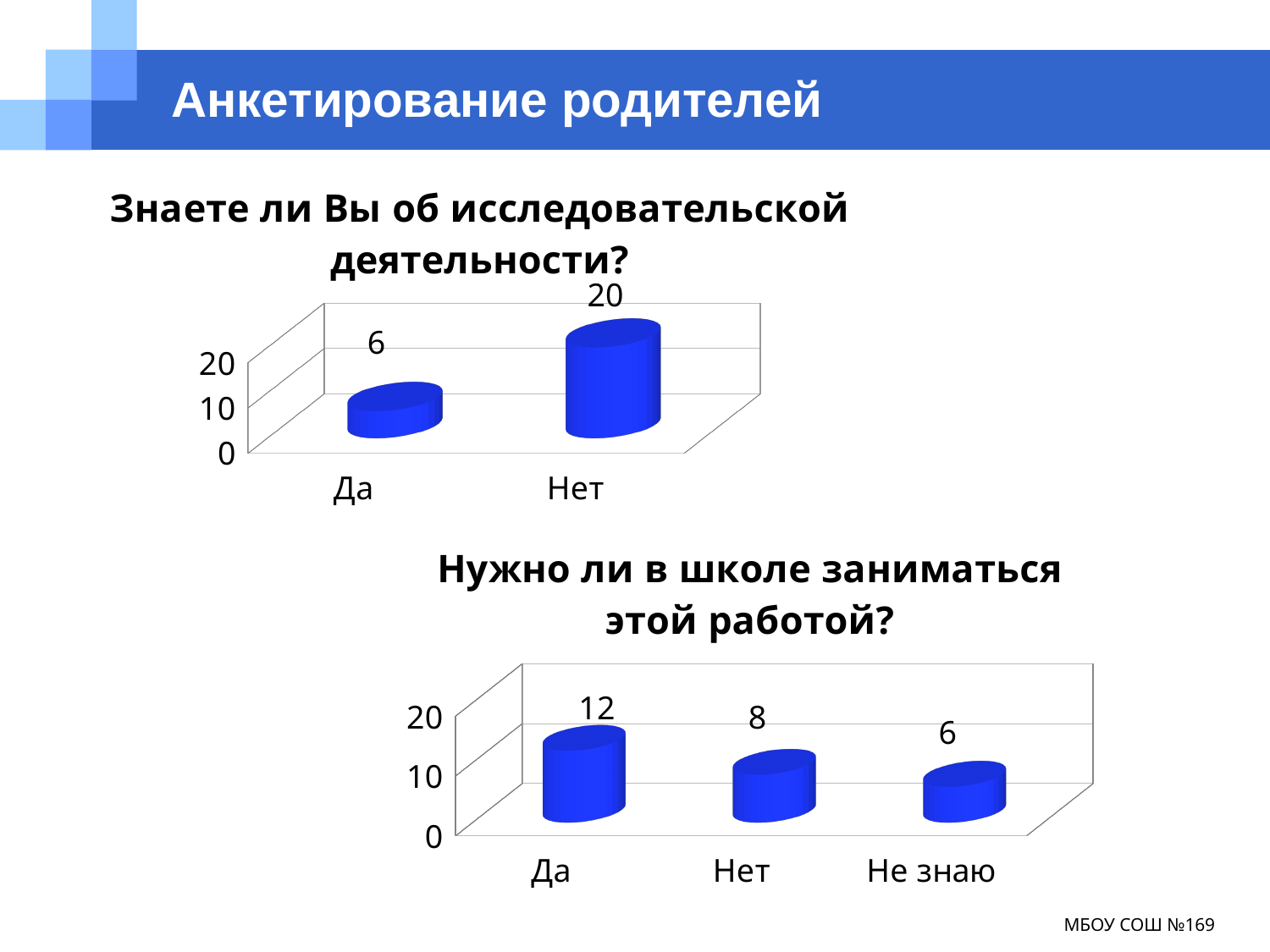
What kind of chart is the lower chart on the slide? Bar chart In the chart titled 'Нужно ли в школе заниматься этой работой?', which is larger, the value for 'Да' or the value for 'Нет'? Да In the chart titled 'Знаете ли Вы об исследовательской деятельности?', what is the difference between the values for 'Нет' and 'Да'? 14 In the chart titled 'Знаете ли Вы об исследовательской деятельности?', what is the value for 'Да'? 6 In the chart titled 'Нужно ли в школе заниматься этой работой?', which category has the lowest value? Не знаю In the chart titled 'Нужно ли в школе заниматься этой работой?', what is the value for 'Не знаю'? 6 In the chart titled 'Нужно ли в школе заниматься этой работой?', how many categories are shown on the x axis? 3 In the chart titled 'Знаете ли Вы об исследовательской деятельности?', what is the value for 'Нет'? 20 In the chart titled 'Нужно ли в школе заниматься этой работой?', what is the value for 'Да'? 12 In the chart titled 'Знаете ли Вы об исследовательской деятельности?', which category has the highest value? Нет In the chart titled 'Нужно ли в школе заниматься этой работой?', what is the value for 'Нет'? 8 In the chart titled 'Знаете ли Вы об исследовательской деятельности?', how many categories are shown? 2